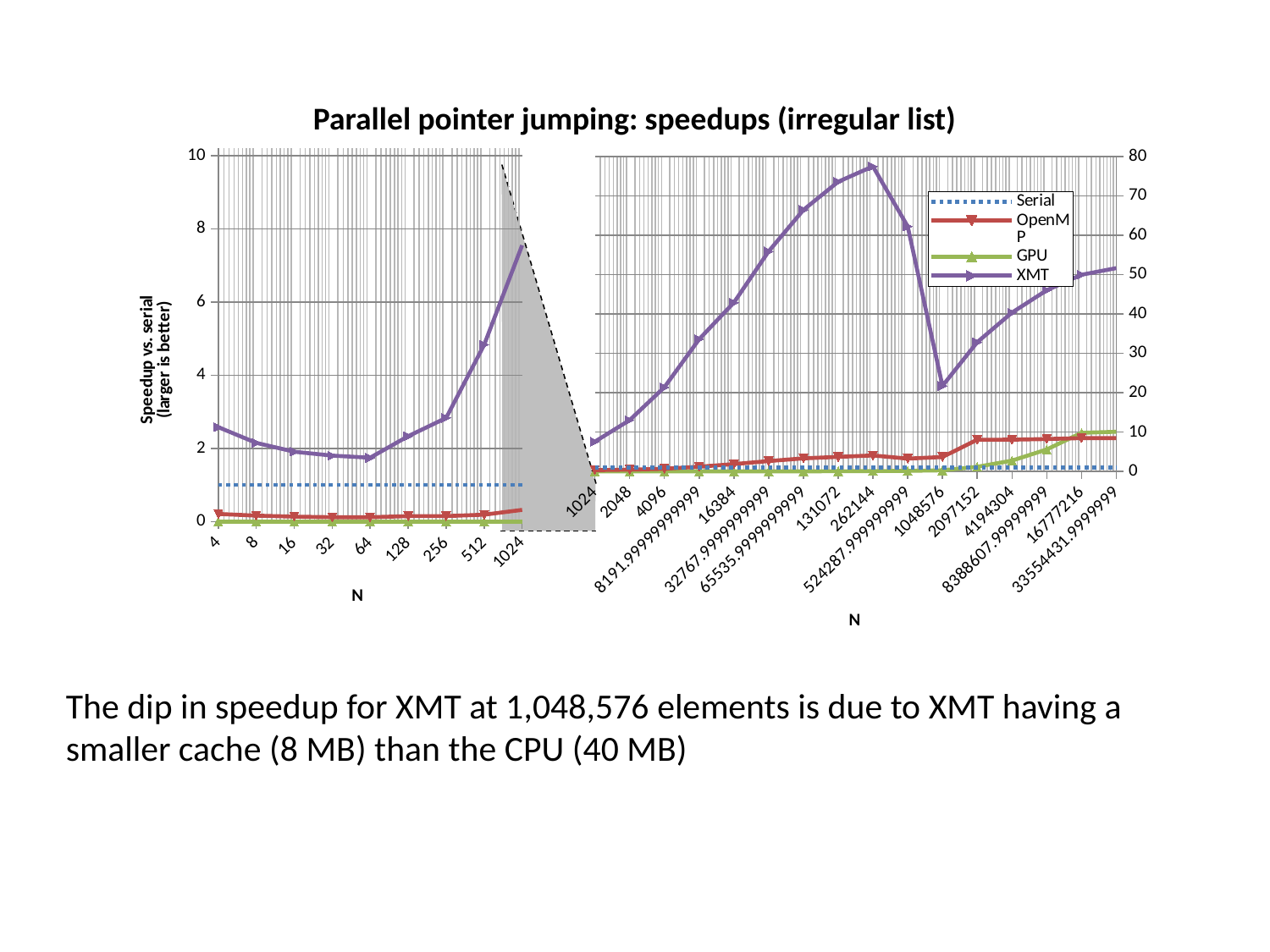
In the right chart, at which N does the XMT series reach its highest value? 262144 In the right chart (N from 1024 upward), how many N values are plotted along the x axis? 16 In the right chart, is the XMT value at N = 262144 greater or less than 70? greater In the right chart, is the XMT value at N = 1048576 greater or less than 30? less What kind of chart is used on the slide? line chart In the left chart, is the XMT value at N = 1024 greater or less than 6? greater In the right chart, does the XMT series rise or fall from N = 1024 to N = 262144? rise How many series does the legend list? 4 In the left chart (N from 4 to 1024), how many N values are plotted along the x axis? 9 In the left chart, at which N does the XMT series reach its highest value? 1024 What is the title of the chart on the slide? Parallel pointer jumping: speedups (irregular list)